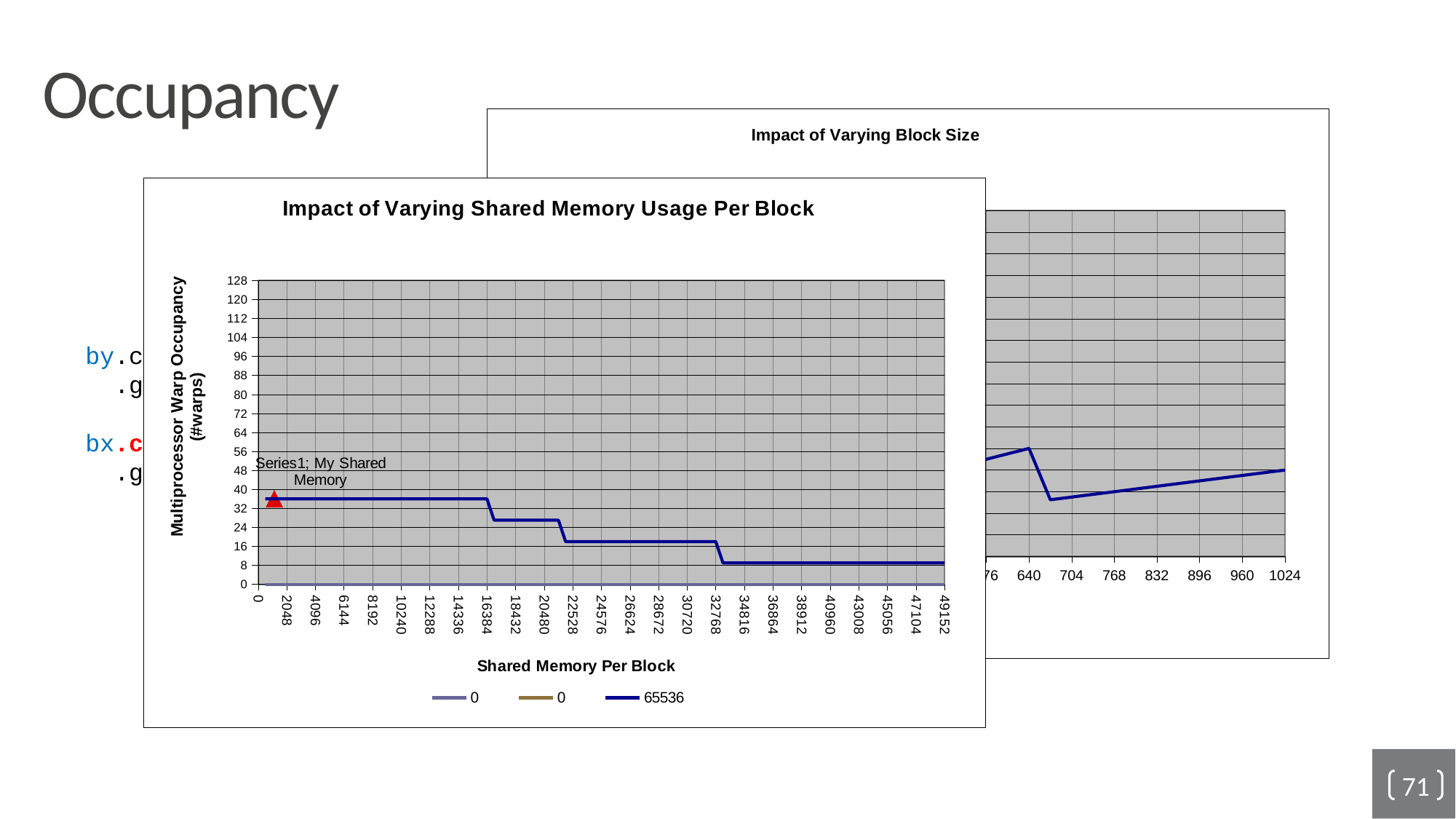
In the 'Impact of Varying Shared Memory Usage Per Block' chart, is the value of the 65536 series at 8192 greater or less than 24? greater What is the title of the chart partially hidden behind the front chart? Impact of Varying Block Size In the 'Impact of Varying Shared Memory Usage Per Block' chart, which is larger for the 65536 series: the value at 4096 or the value at 40960? the value at 4096 In the 'Impact of Varying Block Size' chart, do the values rise or fall between 704 and 1024 on the x axis? rise In the 'Impact of Varying Shared Memory Usage Per Block' chart, is the value of the 65536 series at 28672 greater or less than 24? less What kind of chart is the 'Impact of Varying Shared Memory Usage Per Block' chart? line chart What is the title of the chart in front on the slide? Impact of Varying Shared Memory Usage Per Block How many series does the legend of the 'Impact of Varying Shared Memory Usage Per Block' chart list? 3 In the 'Impact of Varying Shared Memory Usage Per Block' chart, do the values of the 65536 series rise or fall as shared memory per block increases? fall In the 'Impact of Varying Shared Memory Usage Per Block' chart, is the value of the 65536 series at 8192 greater or less than 48? less How many tick labels are shown on the x axis of the 'Impact of Varying Shared Memory Usage Per Block' chart? 25